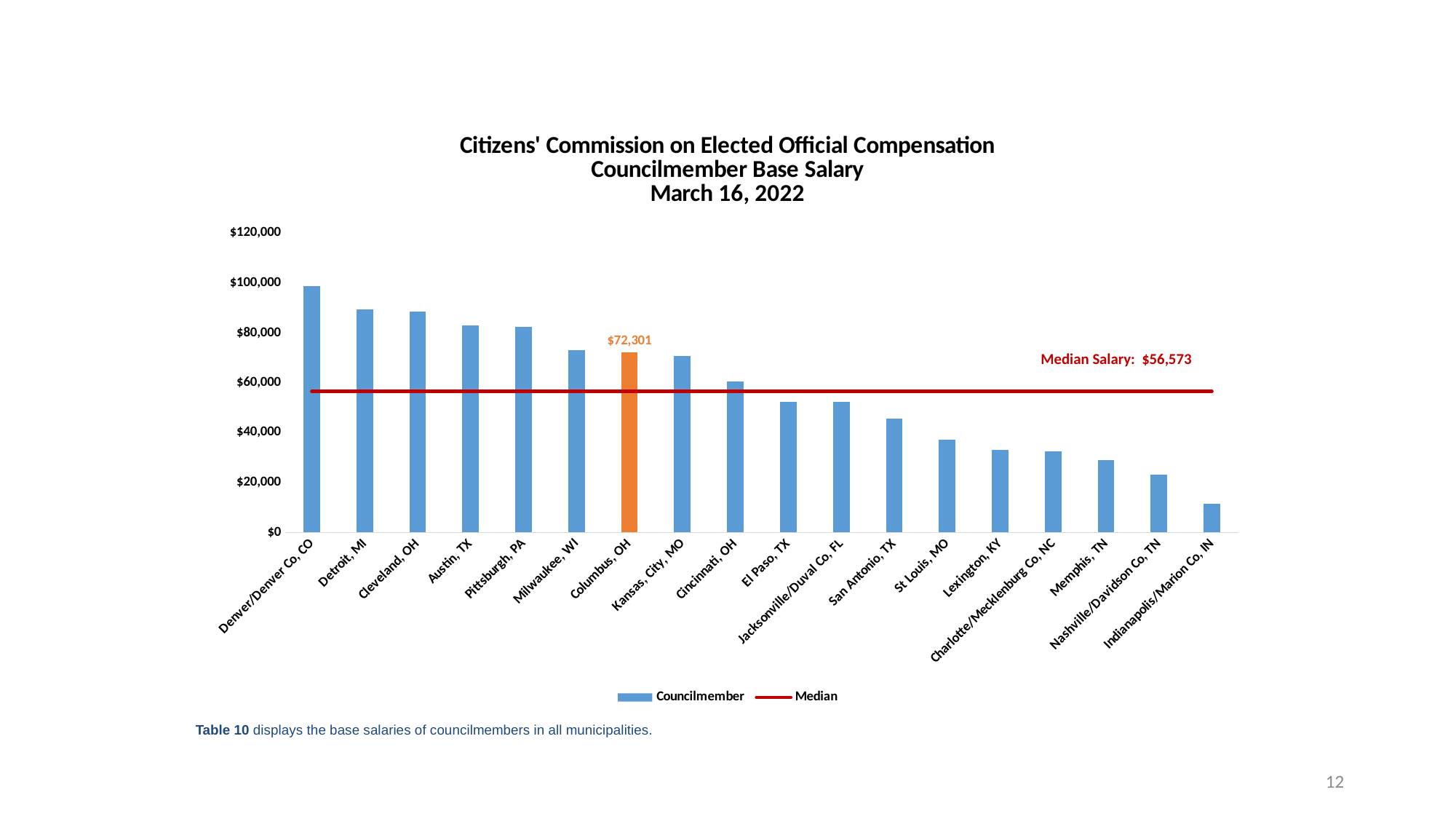
What median salary is shown on the chart? $56,573 Do the councilmember base salaries rise or fall from left to right across the chart? fall What is the councilmember base salary shown for Columbus, OH? $72,301 Which has a higher councilmember base salary, Denver/Denver Co, CO or Detroit, MI? Denver/Denver Co, CO How many municipalities are shown on the chart? 18 Which municipality has the highest councilmember base salary? Denver/Denver Co, CO Is the councilmember base salary for Denver/Denver Co, CO greater or less than $80,000? greater Is the councilmember base salary for El Paso, TX greater or less than $60,000? less Is the councilmember base salary for Indianapolis/Marion Co, IN greater or less than $20,000? less How many series does the legend list? 2 Which municipality has the lowest councilmember base salary? Indianapolis/Marion Co, IN